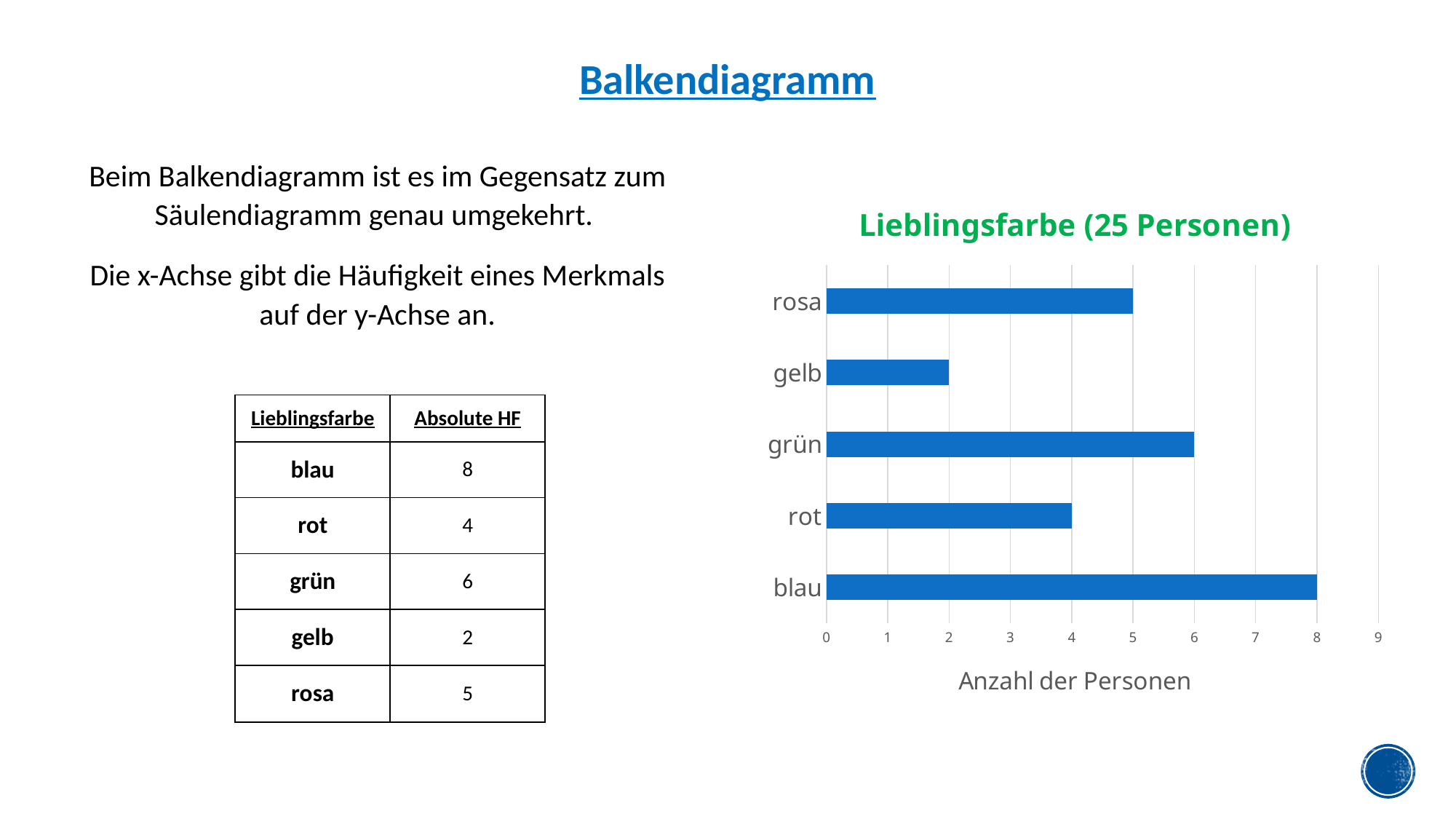
What is the value for blau in the chart? 8 Is the value for rot greater or less than 5? less Which colour has the lowest value in the chart? gelb What is the label of the horizontal axis of the chart? Anzahl der Personen What kind of chart is shown on the slide? bar chart What is the value for rosa in the chart? 5 Which colour has the highest value in the chart? blau How many categories are shown in the chart? 5 What is the difference between the values for blau and rot? 4 What is the value for gelb in the chart? 2 What is the title of the chart? Lieblingsfarbe (25 Personen) Which has a larger value, grün or rosa? grün